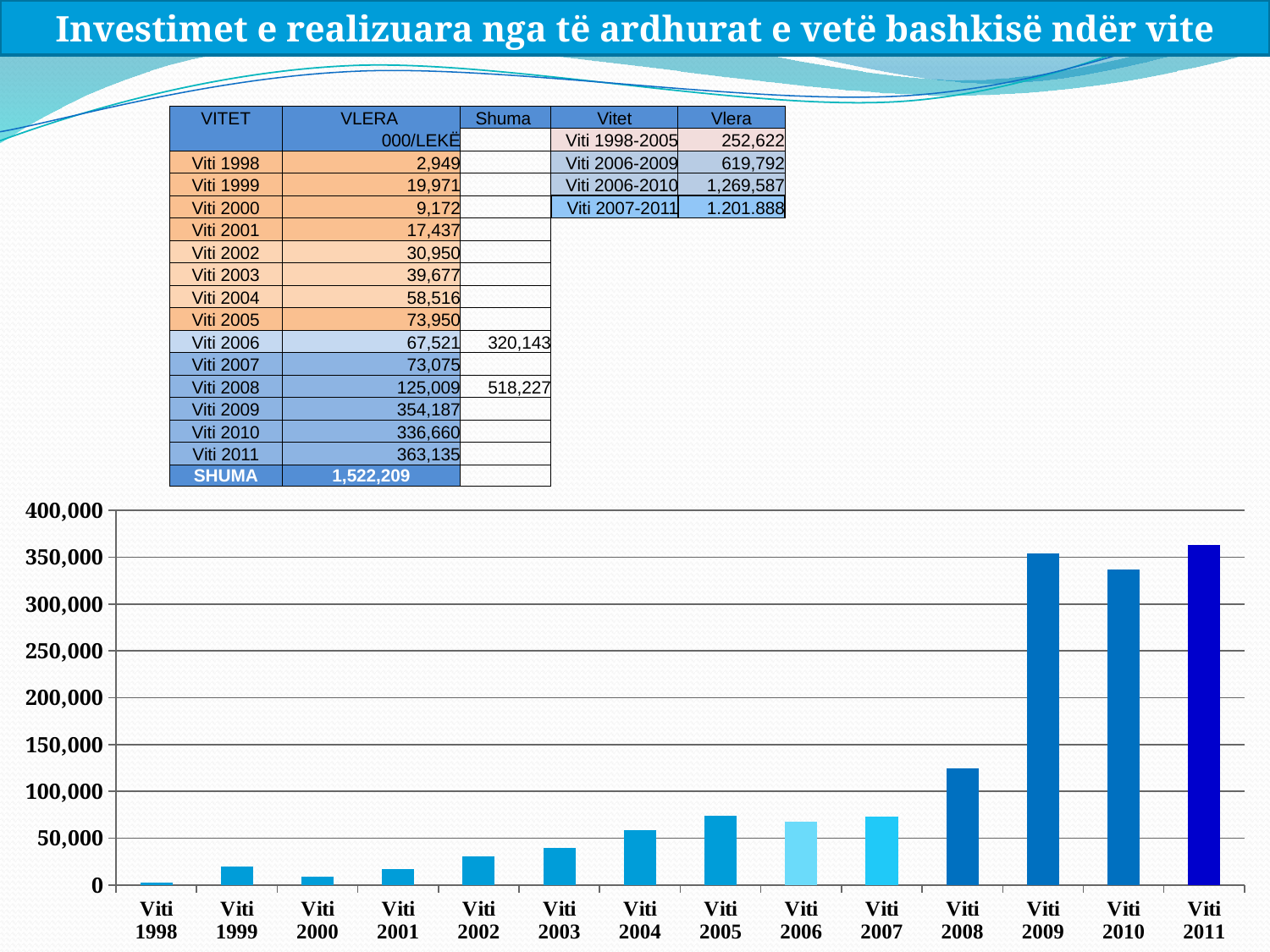
What is the highest tick value shown on the y axis of the bar chart? 400,000 Do the bar values generally rise or fall from Viti 1998 to Viti 2011? rise Is the bar for Viti 2008 greater or less than 100,000? greater Is the bar for Viti 2005 greater or less than 100,000? less Which bar is taller, Viti 2007 or Viti 2008? Viti 2008 Which year has the lowest bar in the chart? Viti 1998 How many years (categories) are plotted on the x axis of the bar chart? 14 According to the table, what is the value for Viti 2010? 336,660 Using the table values, what is the difference between Viti 2011 and Viti 2010? 26,475 According to the table, what is the value (VLERA) for Viti 2004? 58,516 Is the bar for Viti 2009 greater or less than 300,000? greater What kind of chart is shown at the bottom of the slide? bar chart